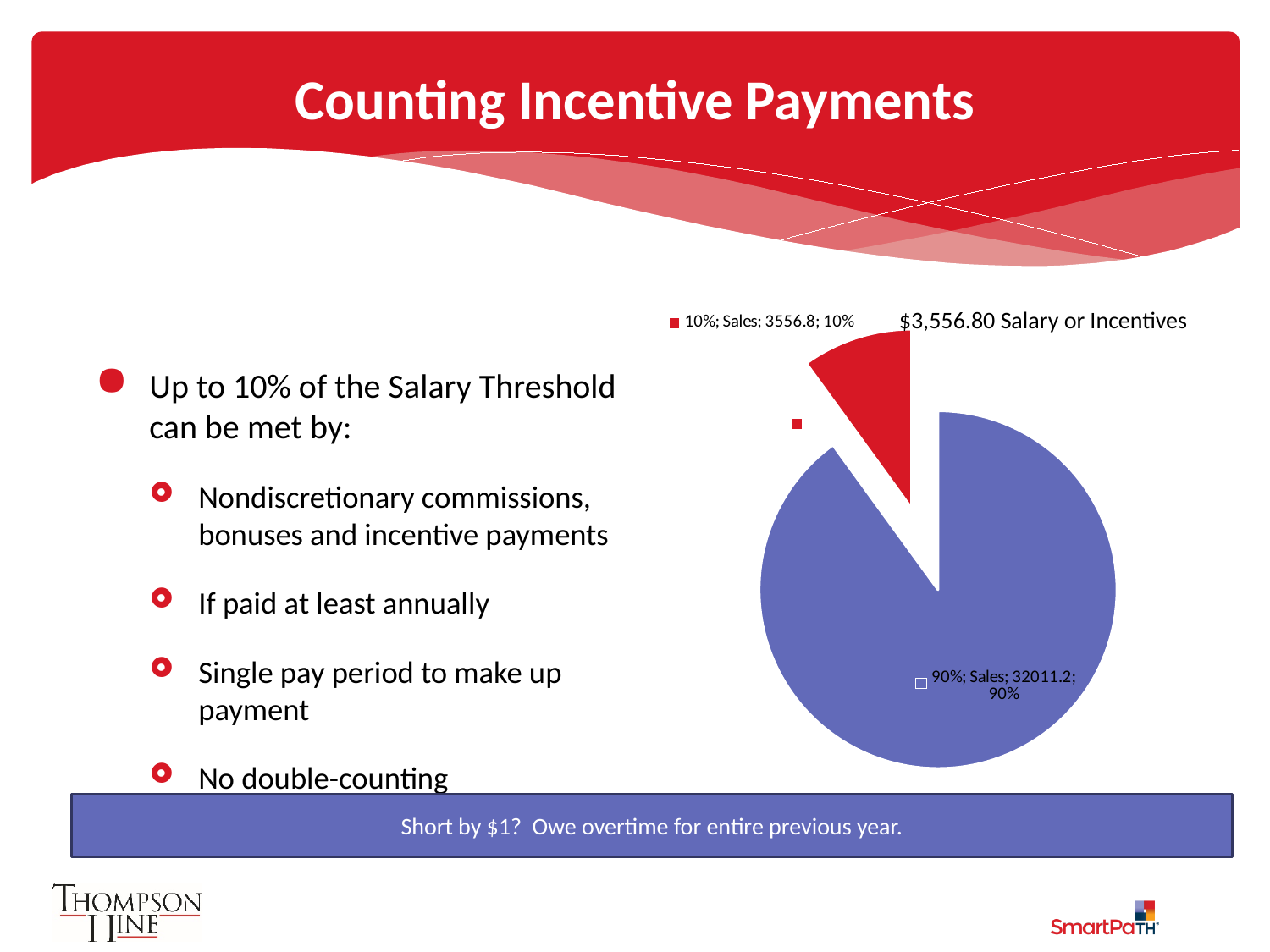
What is the difference between the values of the 90% slice and the 10% slice? 28454.4 What colour is the 10% slice of the pie chart? red What value is labelled on the 10% slice of the pie chart? 3556.8 What is the total of the two slice values in the pie chart? 35568 How many slices does the pie chart have? 2 What share of the pie does the blue slice represent? 90% What value is labelled on the 90% slice of the pie chart? 32011.2 Which slice of the pie chart is the largest? 90% Which slice of the pie chart is the smallest? 10% What kind of chart is shown on the slide? pie chart What share of the pie does the red slice represent? 10% Which is larger, the value of the 10% slice or the value of the 90% slice? the 90% slice